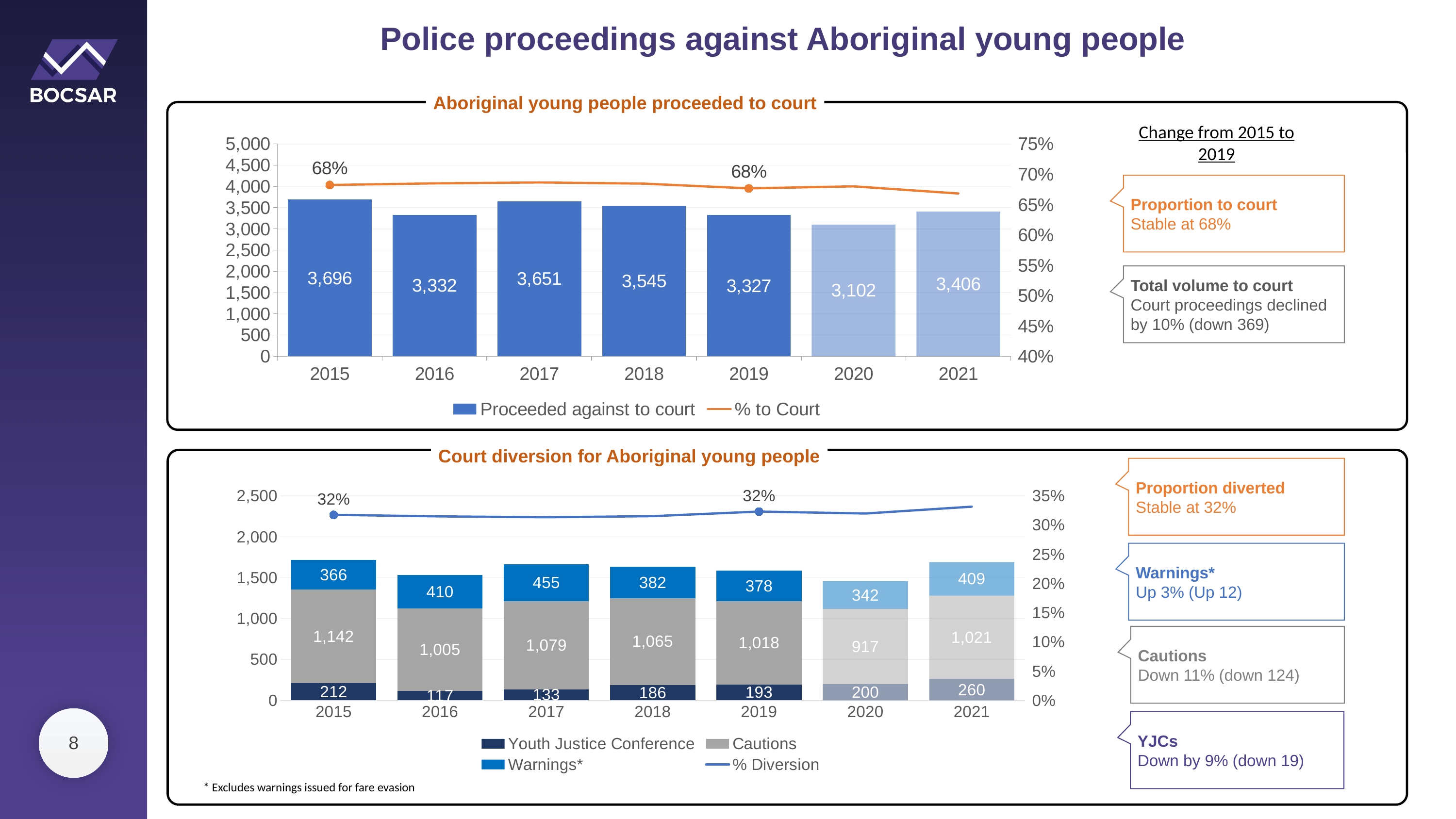
In the 'Aboriginal young people proceeded to court' chart, what is the difference between the 2015 and 2019 values for proceeded against to court? 369 In the 'Aboriginal young people proceeded to court' chart, how many Aboriginal young people were proceeded against to court in 2015? 3,696 In the 'Aboriginal young people proceeded to court' chart, how many series does the legend list? 2 In the 'Court diversion for Aboriginal young people' chart, is the Cautions value larger in 2015 or 2016? 2015 In the 'Court diversion for Aboriginal young people' chart, what is the total of the stacked bar for 2021? 1,690 In the 'Court diversion for Aboriginal young people' chart, what is the Warnings* value for 2017? 455 In the 'Court diversion for Aboriginal young people' chart, what is the Cautions value for 2020? 917 In the 'Court diversion for Aboriginal young people' chart, how many years are shown on the x axis? 7 In the 'Aboriginal young people proceeded to court' chart, which year has the lowest number proceeded against to court? 2020 In the 'Court diversion for Aboriginal young people' chart, which year has the highest Youth Justice Conference value? 2021 In the 'Aboriginal young people proceeded to court' chart, which year has the highest number proceeded against to court? 2015 In the 'Aboriginal young people proceeded to court' chart, what is the % to Court value labelled for 2019? 68%